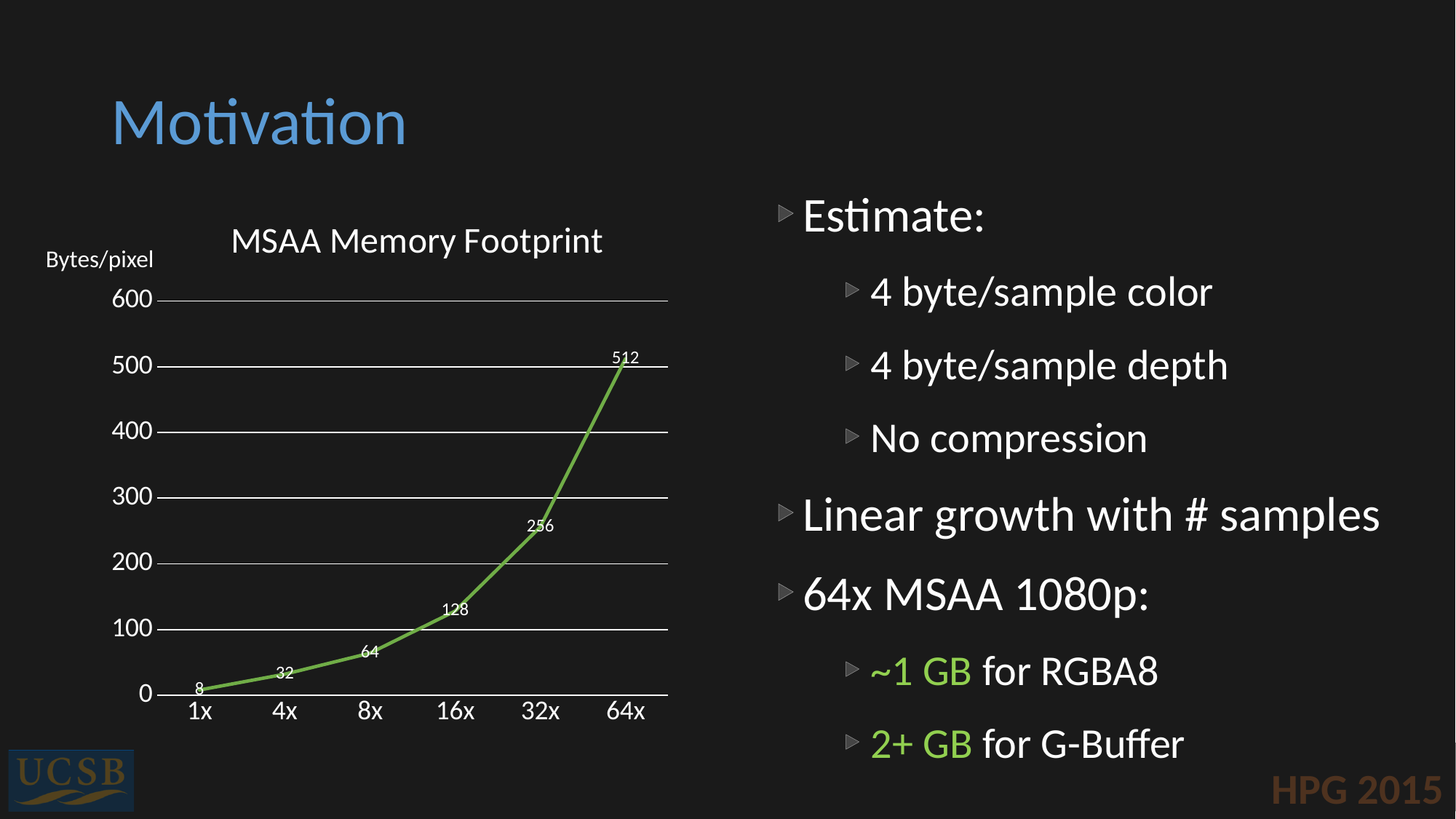
Is the value for 32x greater or less than 300? less What is the difference in bytes/pixel between 64x and 32x? 256 Which sample count has the highest bytes/pixel in the chart? 64x What is the difference in bytes/pixel between 16x and 4x? 96 Which has a larger value, 16x or 8x? 16x What kind of chart is the MSAA Memory Footprint chart? line chart Do the values rise or fall as the sample count increases along the x axis? rise Which sample count has the lowest bytes/pixel in the chart? 1x How many sample counts are plotted on the x axis of the chart? 6 What is the value for 64x in the MSAA Memory Footprint chart? 512 What is the value for 1x in the MSAA Memory Footprint chart? 8 What is the value for 8x in the MSAA Memory Footprint chart? 64